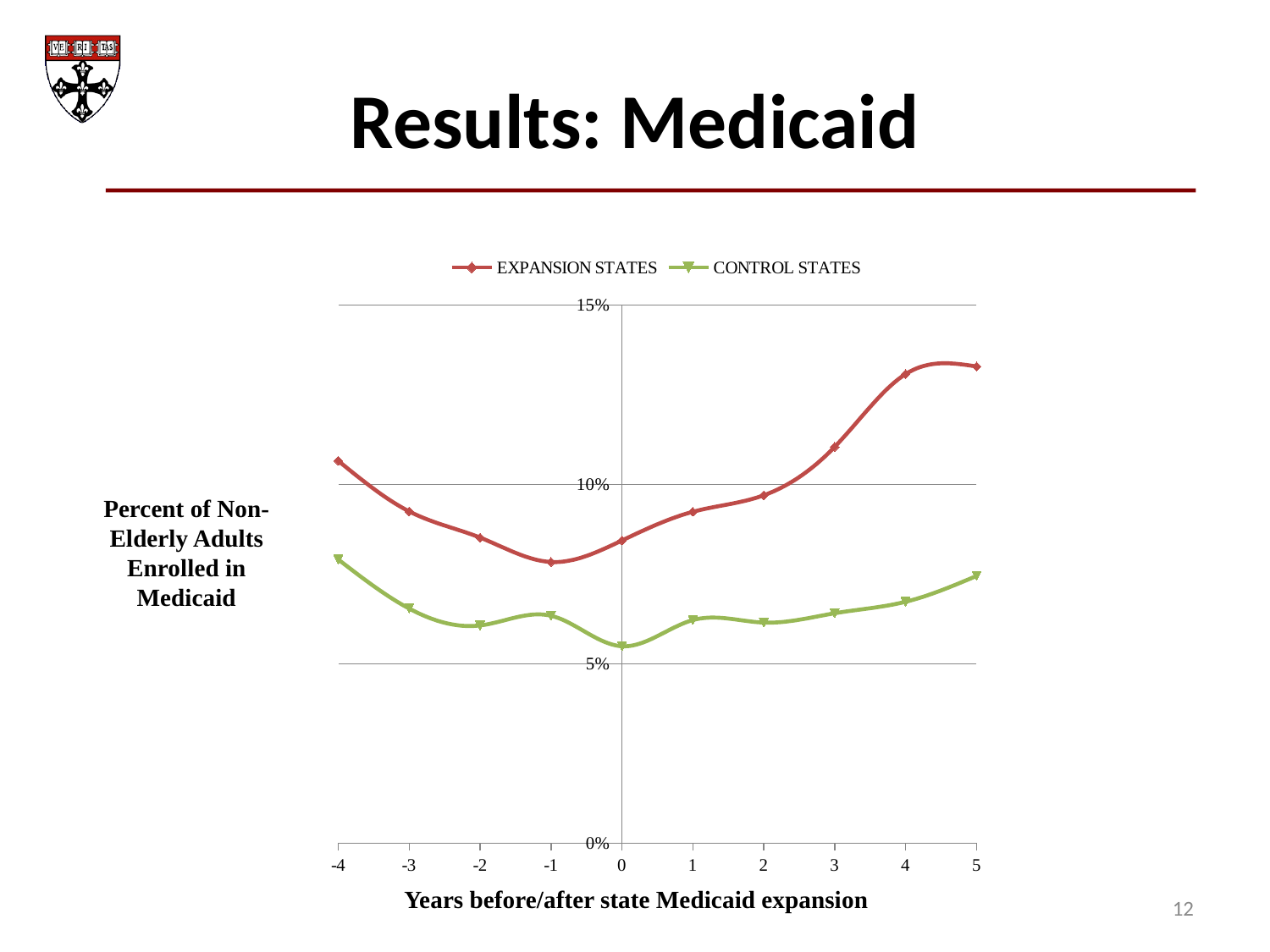
Is the value for Control States at year 0 greater or less than 5%? greater Does the Expansion States line rise or fall from year 0 to year 5? rise Is the value for Expansion States at year 4 greater or less than 10%? greater Is the value for Expansion States at year -1 greater or less than 10%? less How many points along the x axis (years) does each line have? 10 What kind of chart is shown on the slide? line chart At which year does the Control States line reach its lowest value? 0 At which year does the Expansion States line reach its lowest value? -1 How many series does the legend list? 2 At year 5, which series has the higher value, Expansion States or Control States? Expansion States What is the title of the x axis? Years before/after state Medicaid expansion